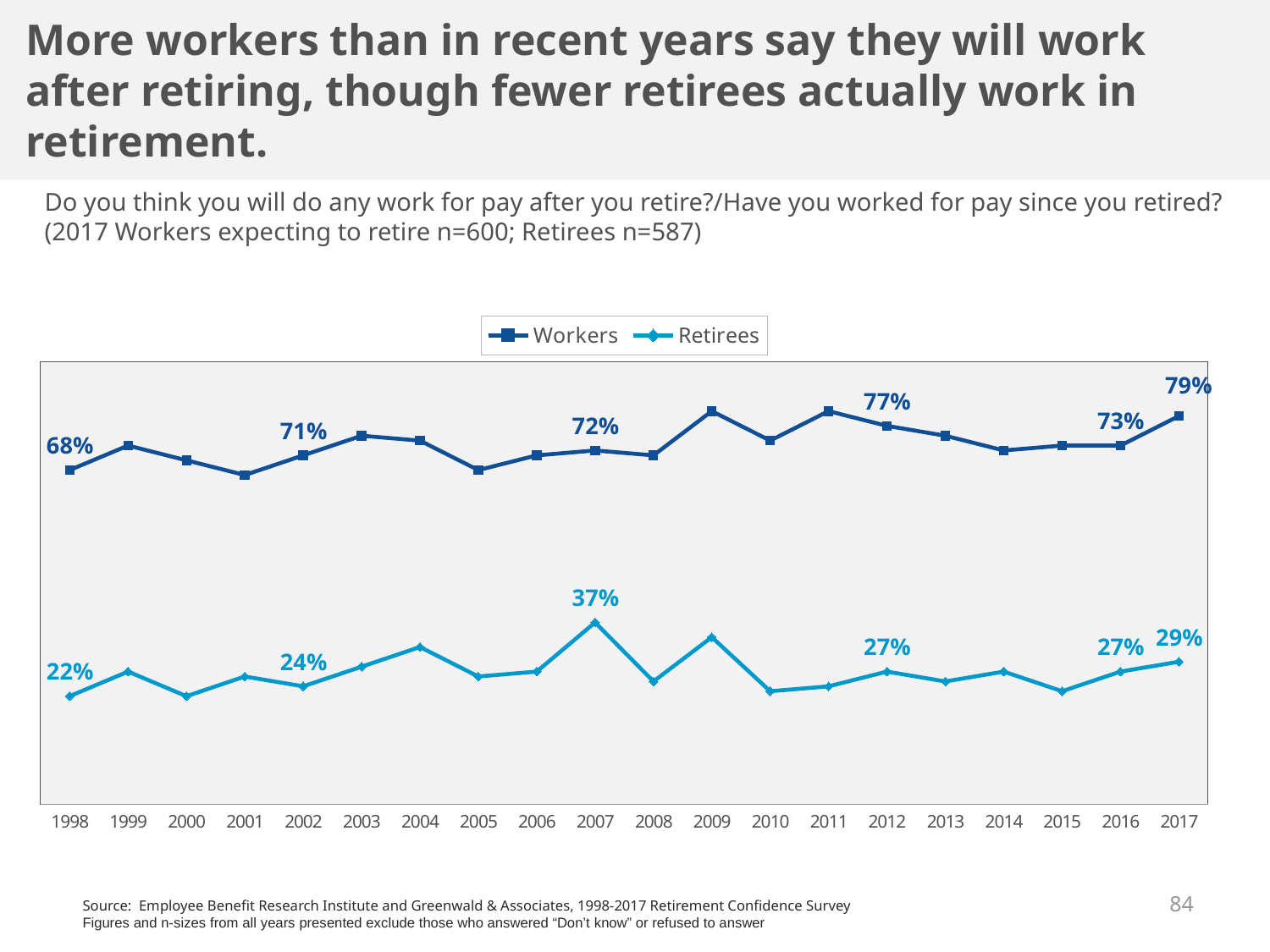
In which year does the Retirees line reach its highest value? 2007 What percentage of Retirees reported working for pay since retiring in 2007? 37% What is the difference between the Workers and Retirees values in 2017? 50 percentage points What percentage of Workers said they will work for pay after retiring in 2017? 79% Which is larger, the Workers value in 2012 or the Workers value in 2016? 2012 How many series does the legend list? 2 What is the Retirees value for 1998? 22% What kind of chart is shown on the slide? Line chart What is the Workers value for 2012? 77% How many years are shown on the x axis? 20 How much higher is the Retirees value in 2007 than in 1998? 15 percentage points